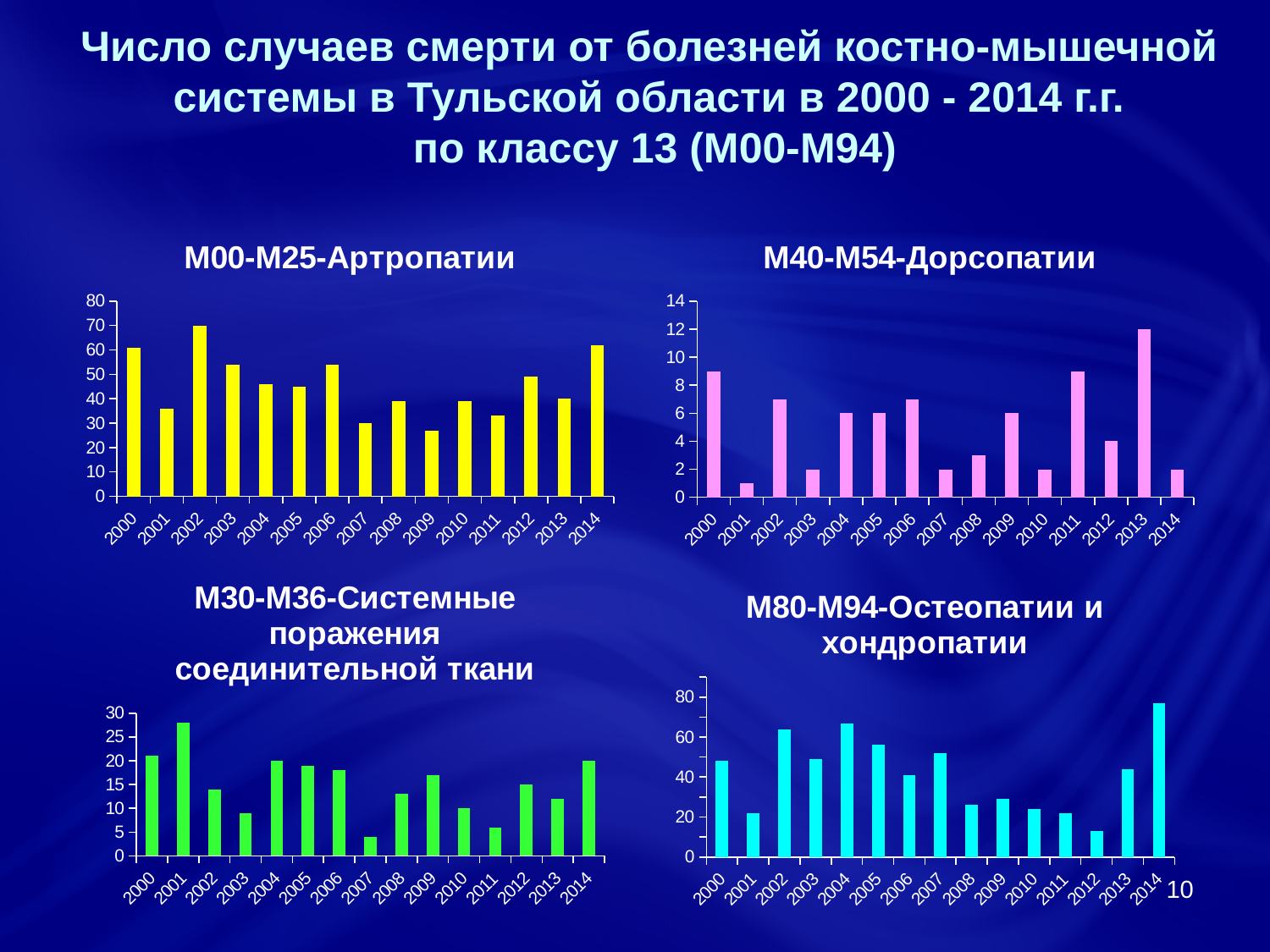
In the M80-M94-Остеопатии и хондропатии chart, which year has the highest value? 2014 In the M30-M36-Системные поражения соединительной ткани chart, which year has the lowest value? 2007 In the M30-M36-Системные поражения соединительной ткани chart, which year has the highest value? 2001 In the M00-M25-Артропатии chart, is the value for 2014 greater or less than 50? greater In the M00-M25-Артропатии chart, which year has the highest value? 2002 In the M00-M25-Артропатии chart, which year has the lowest value? 2009 What kind of chart is the M30-M36-Системные поражения соединительной ткани chart? bar chart In the M80-M94-Остеопатии и хондропатии chart, is the value for 2012 greater or less than 20? less In the M40-M54-Дорсопатии chart, which year has the lowest value? 2001 How many years are shown on the x axis of the M80-M94-Остеопатии и хондропатии chart? 15 In the M40-M54-Дорсопатии chart, what is the value for 2013? 12